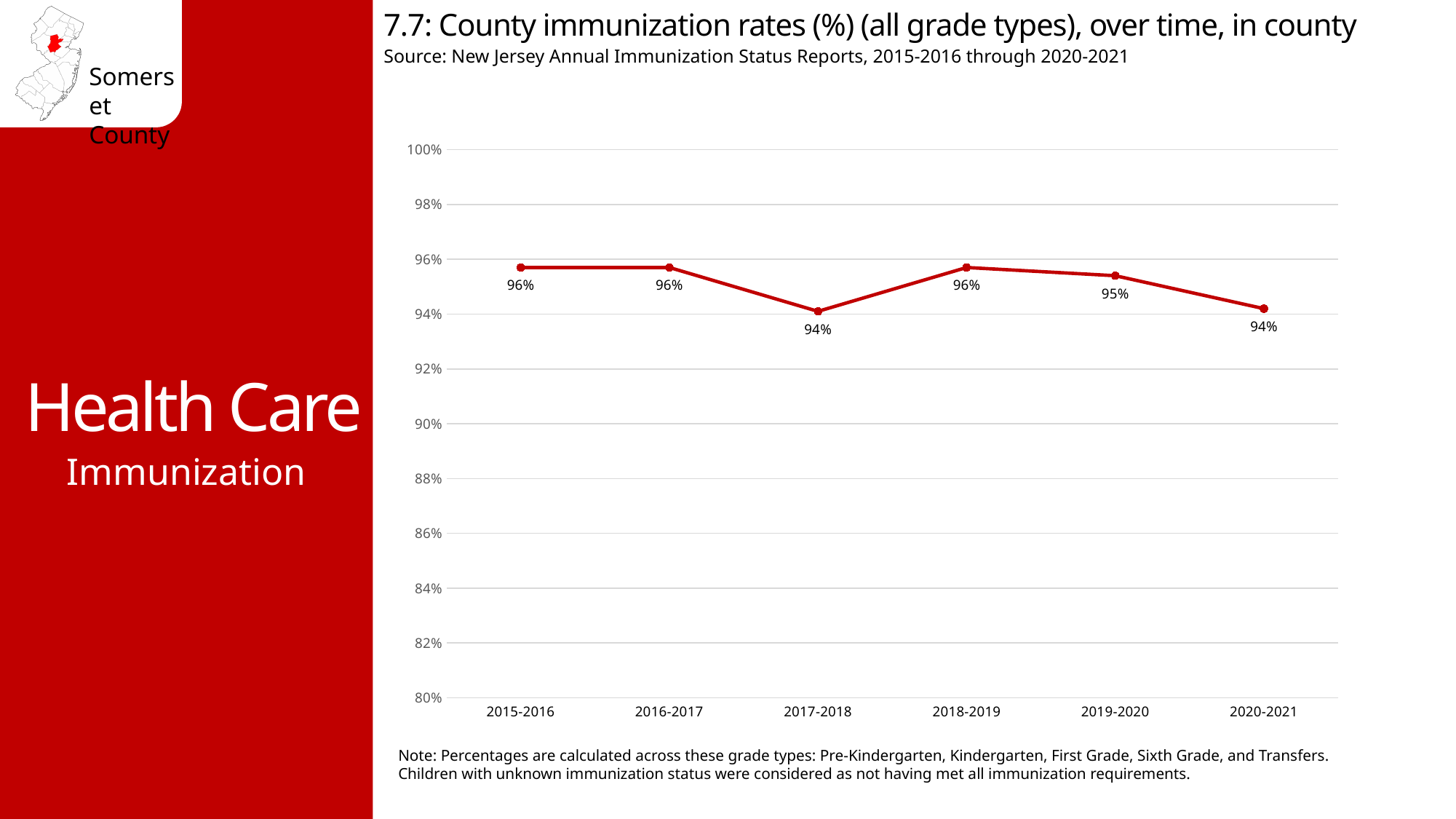
What was the county immunization rate in 2015-2016? 96% What was the county immunization rate in 2017-2018? 94% How many school years are plotted on the chart? 6 What kind of chart is shown on the slide? Line chart Is the value for 2019-2020 greater or less than 96%? less Which year had the higher immunization rate, 2018-2019 or 2020-2021? 2018-2019 What was the county immunization rate in 2019-2020? 95% Does the immunization rate rise or fall from 2018-2019 to 2020-2021? Fall Is the value for 2017-2018 greater or less than 95%? less What was the county immunization rate in 2020-2021? 94% Which year had the higher immunization rate, 2016-2017 or 2017-2018? 2016-2017 What is the difference in percentage points between the immunization rate in 2016-2017 and in 2017-2018? 2 percentage points